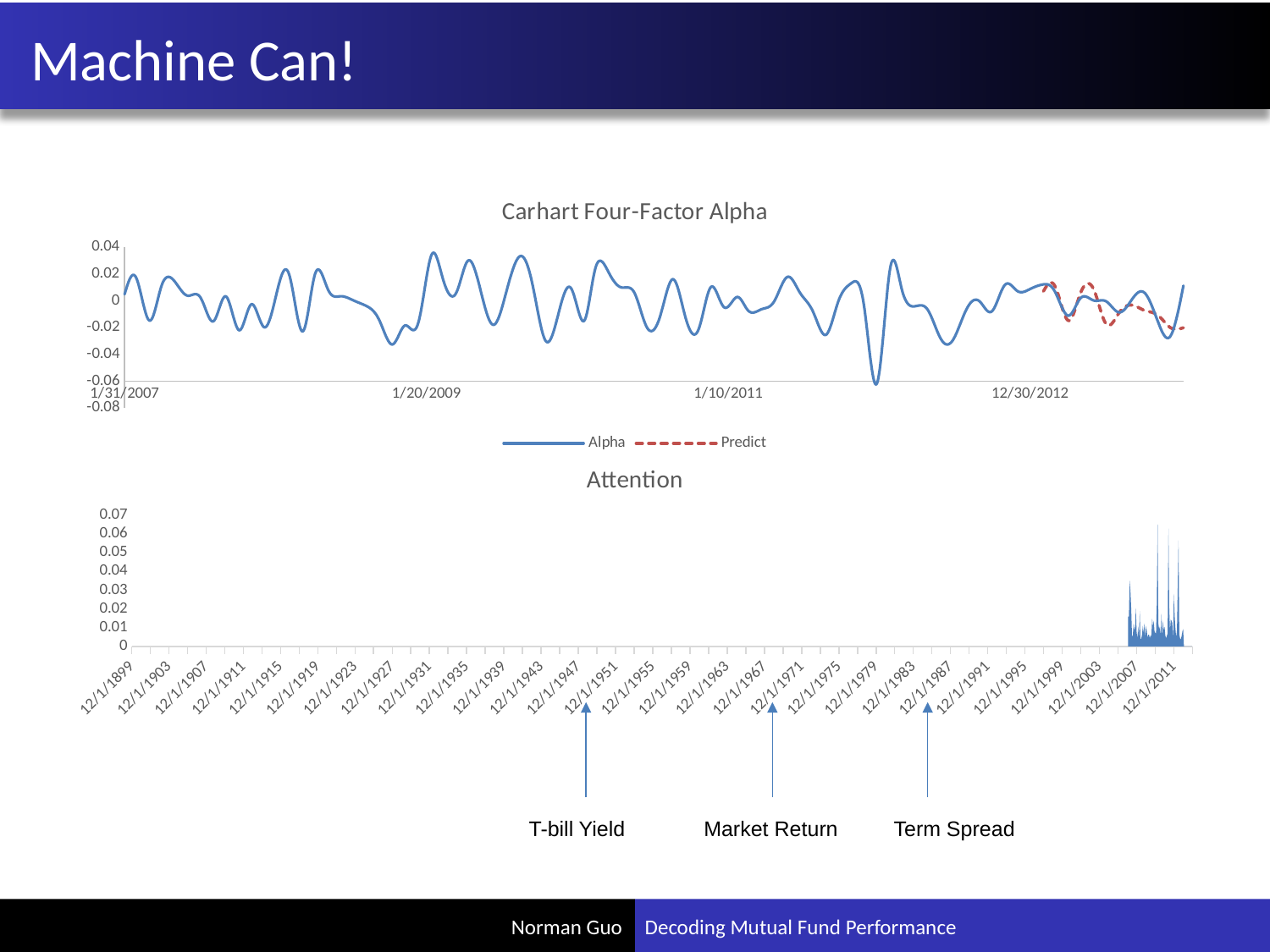
In the Carhart Four-Factor Alpha chart, what is the first date label on the x axis? 1/31/2007 In the Carhart Four-Factor Alpha chart, is the highest value of the Alpha series greater or less than 0.02? greater In the Carhart Four-Factor Alpha chart, how many date labels are shown on the x axis? 4 In the Carhart Four-Factor Alpha chart, which series is drawn with a dashed line? Predict What is the title of the lower chart on the slide? Attention In the Carhart Four-Factor Alpha chart, how many series does the legend list? 2 In the Carhart Four-Factor Alpha chart, is the lowest value of the Alpha series greater or less than -0.04? less What kind of chart is the Carhart Four-Factor Alpha chart? line chart In the Attention chart, what is the highest value shown on the y axis? 0.07 What is the title of the upper chart on the slide? Carhart Four-Factor Alpha In the Attention chart, is the highest plotted value greater or less than 0.05? greater